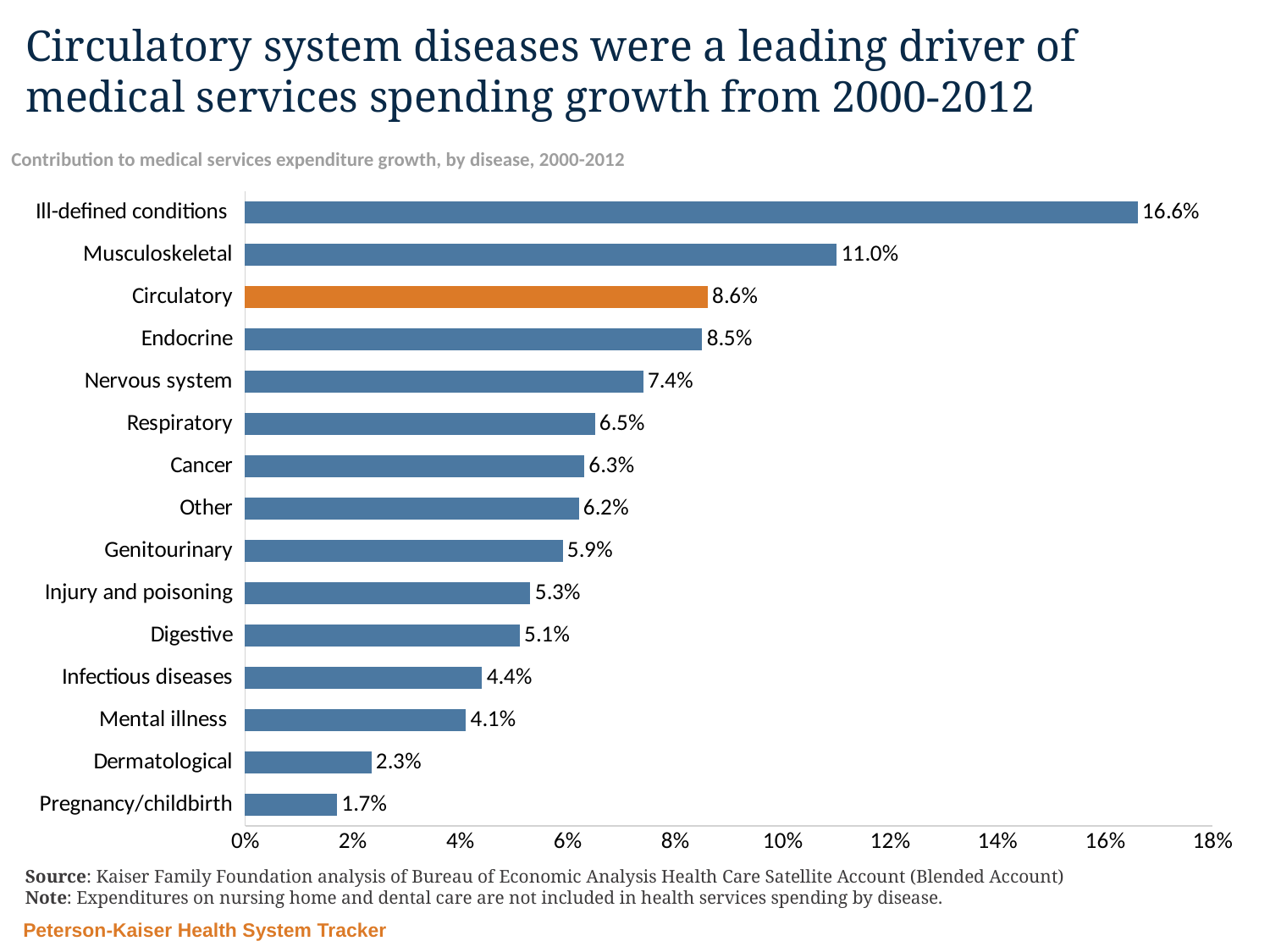
What is the difference between the values for Ill-defined conditions and Musculoskeletal? 5.6% How many disease categories are shown in the chart? 15 What kind of chart is shown on the slide? Bar chart Which category has the highest contribution to expenditure growth? Ill-defined conditions What is the difference between the values for Infectious diseases and Mental illness? 0.3% Which is larger, the value for Respiratory or the value for Digestive? Respiratory What is the value shown for Nervous system? 7.4% What is the value shown for Pregnancy/childbirth? 1.7% What is the contribution to medical services expenditure growth for Circulatory? 8.6% Which category has the lowest contribution to expenditure growth? Pregnancy/childbirth Which bar is highlighted in orange? Circulatory Is the value for Musculoskeletal greater or less than 10%? greater